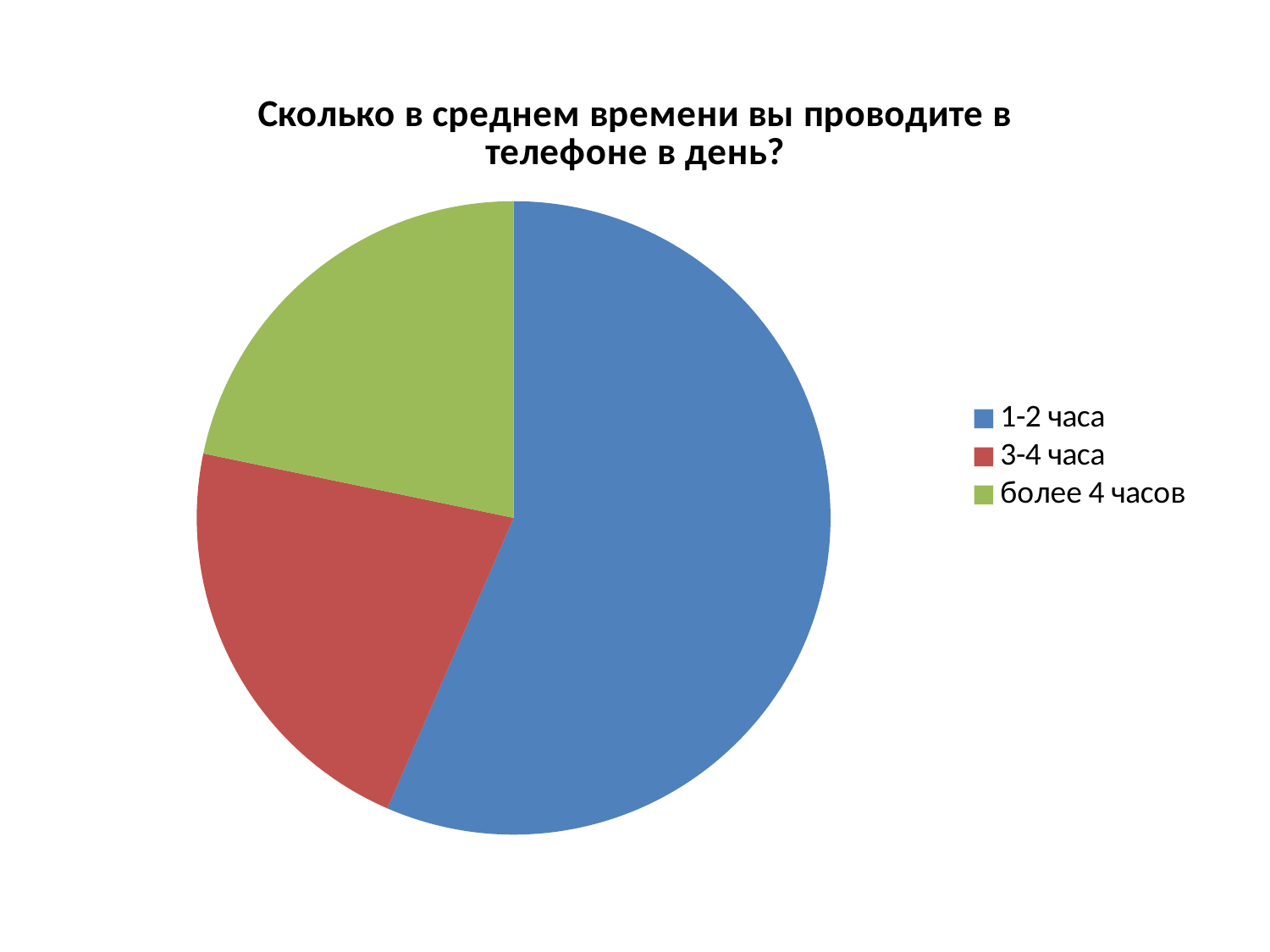
What kind of chart is shown on the slide? pie chart Which slice is larger, "1-2 часа" or "3-4 часа"? 1-2 часа Which category is shown in green? более 4 часов How many slices does the pie chart have? 3 Which category has the largest slice of the pie? 1-2 часа How many entries does the legend list? 3 What is the title of the chart? Сколько в среднем времени вы проводите в телефоне в день? Which slice is larger, "1-2 часа" or "более 4 часов"? 1-2 часа Which colour represents the "3-4 часа" category? red